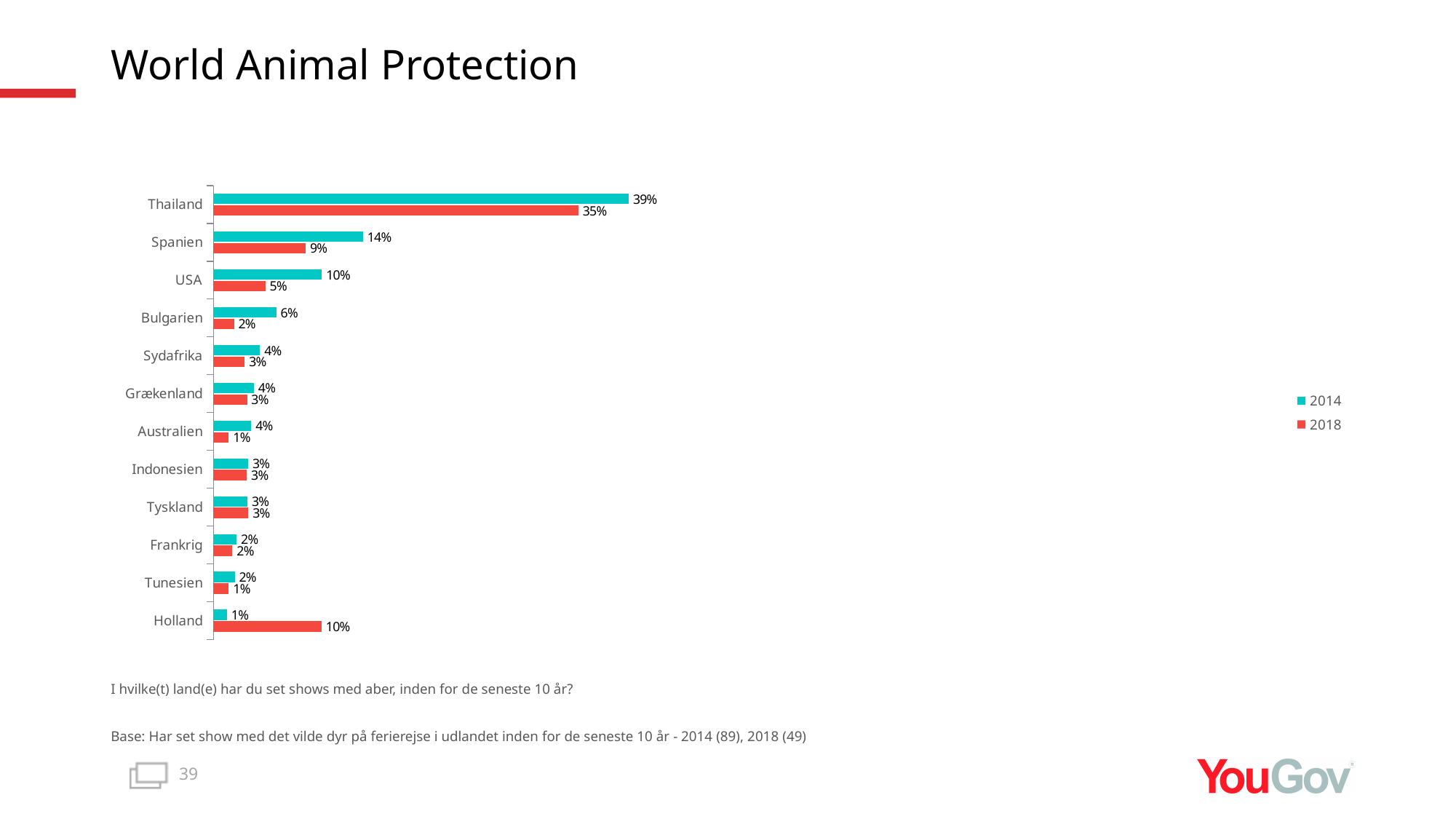
How many series does the legend list? 2 What type of chart is shown on the slide? Bar chart How many countries are shown in the chart? 12 What is the difference between the 2014 and 2018 values for Thailand? 4% Which country has the highest 2018 value? Thailand Which is larger for Holland, the 2014 value or the 2018 value? 2018 What is the 2018 value for Holland? 10% What is the 2018 value for Spanien? 9% Which country has the lowest 2014 value? Holland Which is larger, the 2014 value for Spanien or the 2014 value for USA? Spanien What is the 2014 value for Thailand? 39% What is the difference between the 2014 and 2018 values for USA? 5%